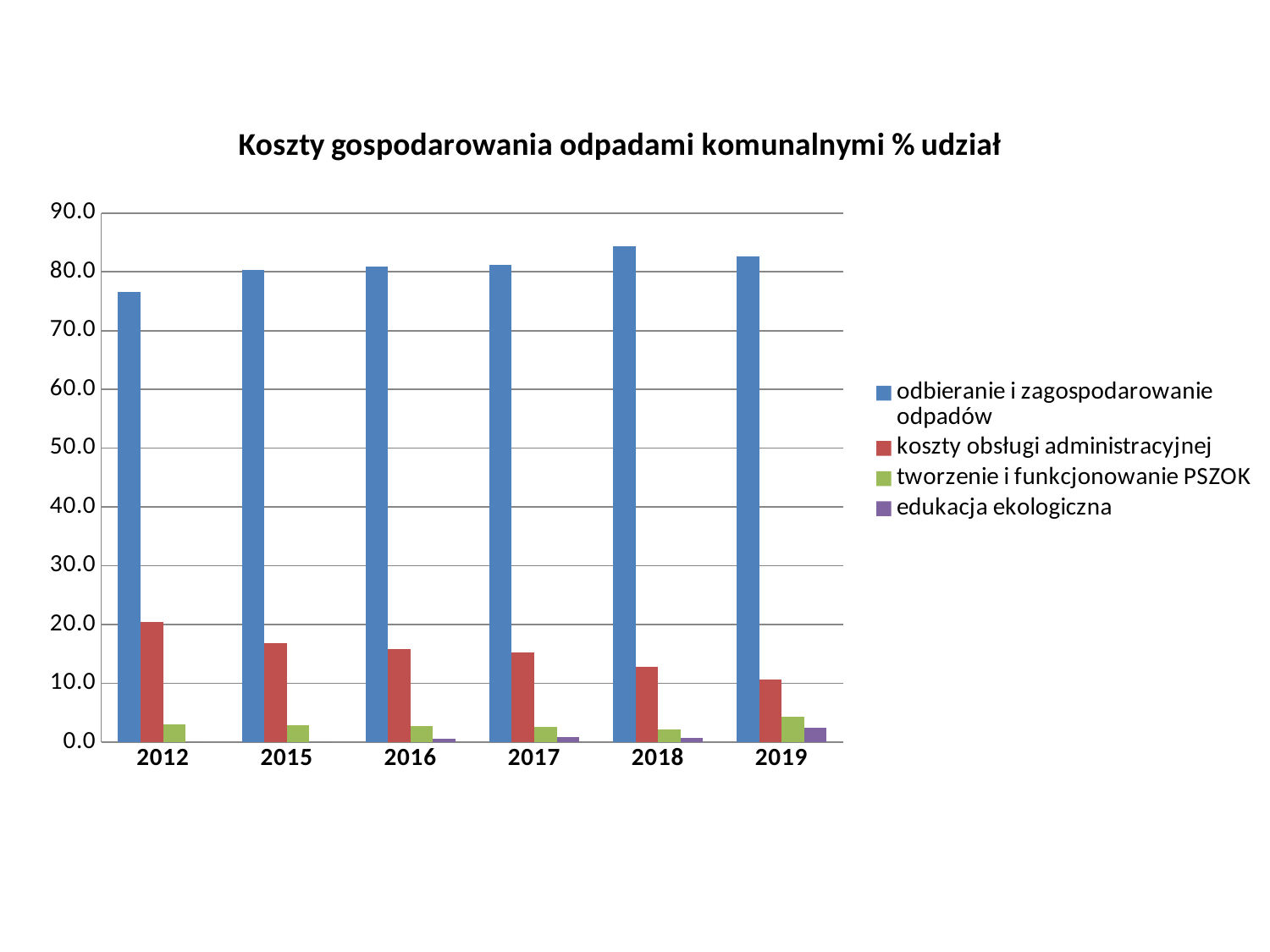
What kind of chart is shown on the slide? bar chart What is the title of the chart? Koszty gospodarowania odpadami komunalnymi % udział How many series does the legend list? 4 Which is larger: the value for 'tworzenie i funkcjonowanie PSZOK' in 2019 or in 2018? 2019 In which year is the value for 'odbieranie i zagospodarowanie odpadów' highest? 2018 In which year is the value for 'odbieranie i zagospodarowanie odpadów' lowest? 2012 In which year is the value for 'koszty obsługi administracyjnej' lowest? 2019 Is the value for 'odbieranie i zagospodarowanie odpadów' in 2012 greater or less than 80.0? less Is the value for 'koszty obsługi administracyjnej' in 2015 greater or less than 20.0? less Do the values for 'koszty obsługi administracyjnej' rise or fall from 2012 to 2019? fall How many years are shown on the x axis? 6 In which year is the value for 'koszty obsługi administracyjnej' highest? 2012